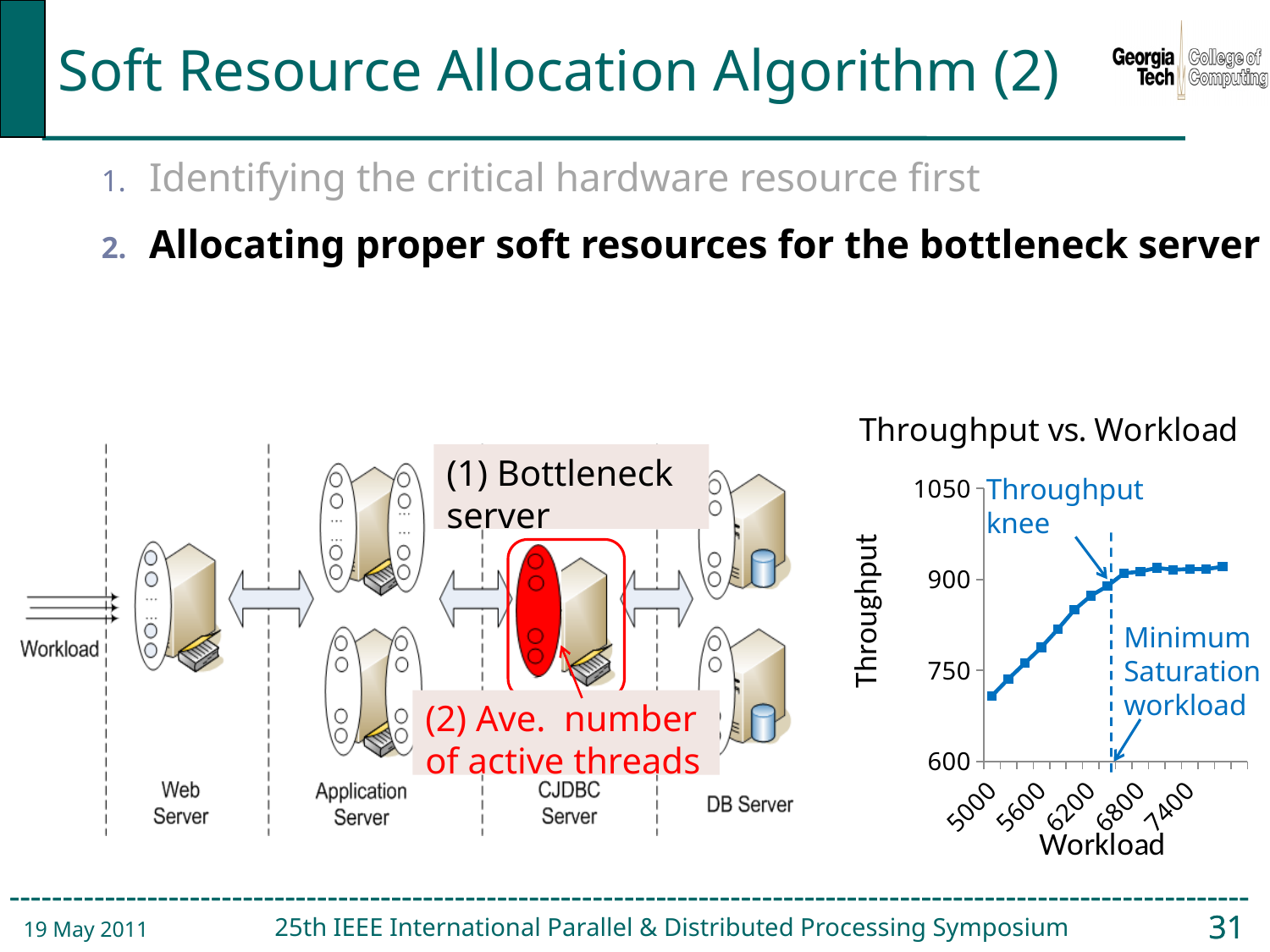
On the Throughput vs. Workload chart, is the throughput at workload 7400 greater or less than 900? greater On the Throughput vs. Workload chart, at which workload is throughput lowest? 5000 What kind of chart is the Throughput vs. Workload chart? line chart On the Throughput vs. Workload chart, does throughput rise or fall as workload increases from 5000 to 6800? rise What is the title of the chart on the right of the slide? Throughput vs. Workload On the Throughput vs. Workload chart, is the throughput at workload 6200 greater or less than 900? less What is the label of the y axis on the Throughput vs. Workload chart? Throughput What is the lowest workload value labelled on the x axis of the Throughput vs. Workload chart? 5000 On the Throughput vs. Workload chart, is the throughput at workload 7400 greater or less than 1050? less What is the highest tick value shown on the y axis of the Throughput vs. Workload chart? 1050 On the Throughput vs. Workload chart, which workload has the higher throughput, 5000 or 7400? 7400